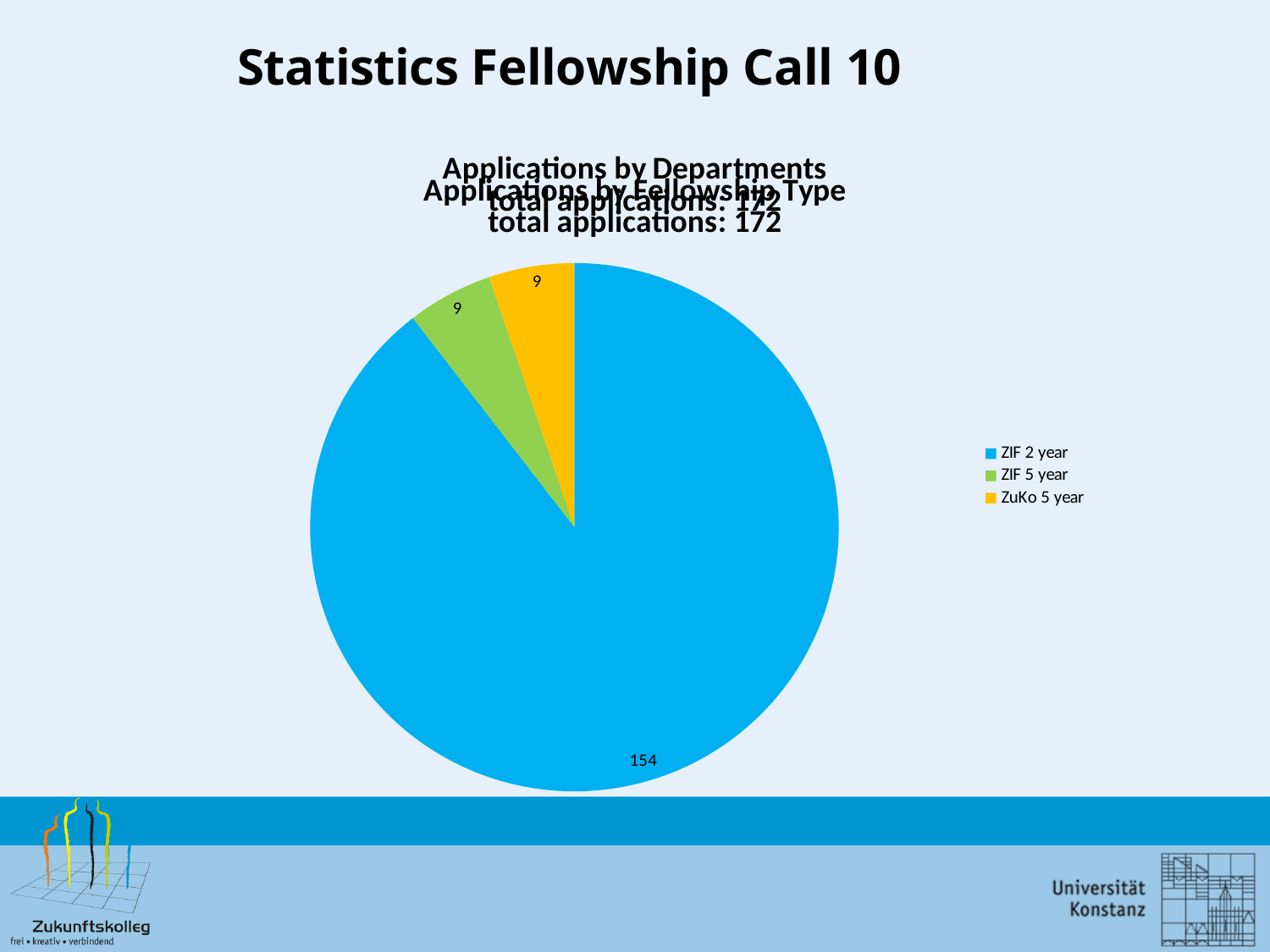
How many applications are shown for ZIF 5 year? 9 How many entries does the legend list? 3 What share of the total applications does ZIF 2 year represent? 89.5% What kind of chart is shown on the slide? pie chart What colour is the ZIF 2 year slice? blue Which has more applications, ZIF 2 year or ZuKo 5 year? ZIF 2 year What is the difference between the number of applications for ZIF 2 year and ZIF 5 year? 145 Which fellowship type has the largest slice of the pie? ZIF 2 year How many slices does the pie chart have? 3 What total number of applications does the chart title state? 172 How many applications are shown for ZuKo 5 year? 9 How many applications are shown for ZIF 2 year? 154